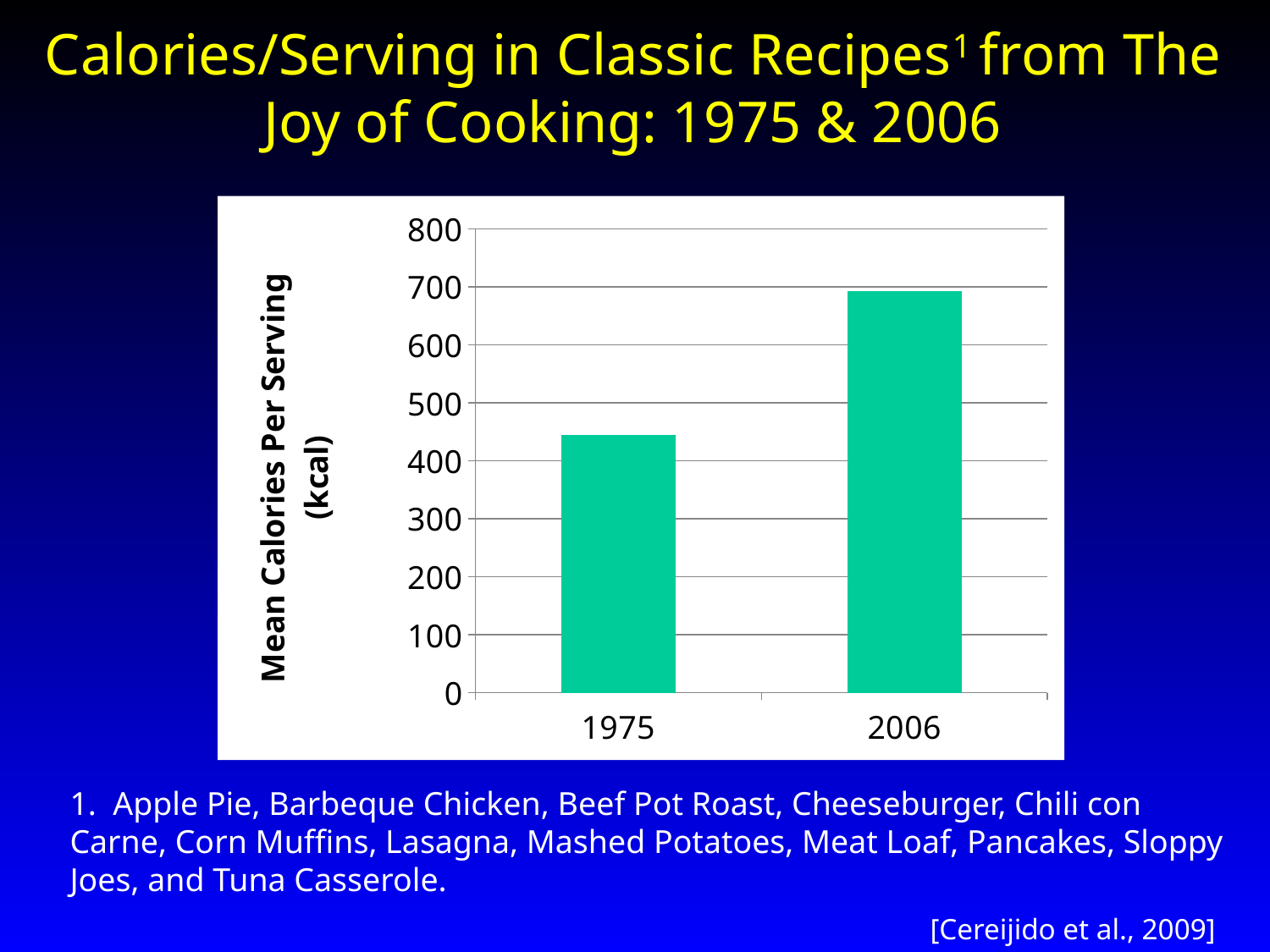
What is the highest value shown on the y axis? 800 Is the value for 1975 greater or less than 500? less What is the label on the y axis? Mean Calories Per Serving (kcal) Which year has the higher mean calories per serving? 2006 Is the value for 2006 greater or less than 700? less Is the value for 2006 greater or less than 600? greater Which is larger, the value for 1975 or the value for 2006? 2006 Do the values rise or fall from 1975 to 2006? rise What kind of chart is shown on the slide? bar chart Which year has the lower mean calories per serving? 1975 How many categories are plotted on the x axis? 2